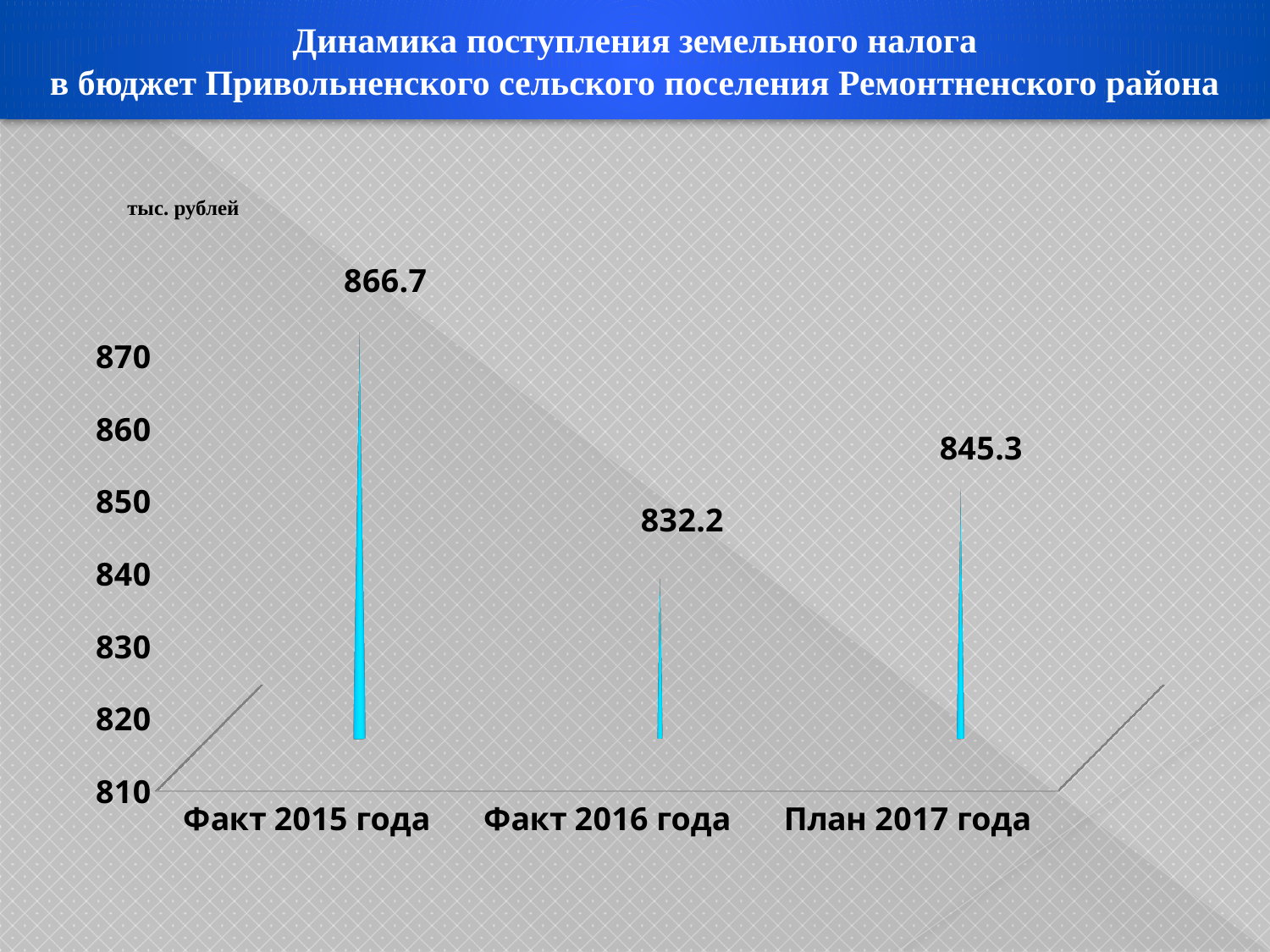
How many categories are shown on the x axis? 3 Which is larger, the value for План 2017 года or the value for Факт 2016 года? План 2017 года What is the value for Факт 2016 года? 832.2 What is the difference between the values for Факт 2015 года and Факт 2016 года? 34.5 What is the difference between the values for План 2017 года and Факт 2016 года? 13.1 Which category has the highest value? Факт 2015 года What unit is indicated for the values on the chart? тыс. рублей Which category has the lowest value? Факт 2016 года What is the value for Факт 2015 года? 866.7 What is the value for План 2017 года? 845.3 What kind of chart is shown on the slide? bar chart Is the value for Факт 2016 года greater or less than 840? less